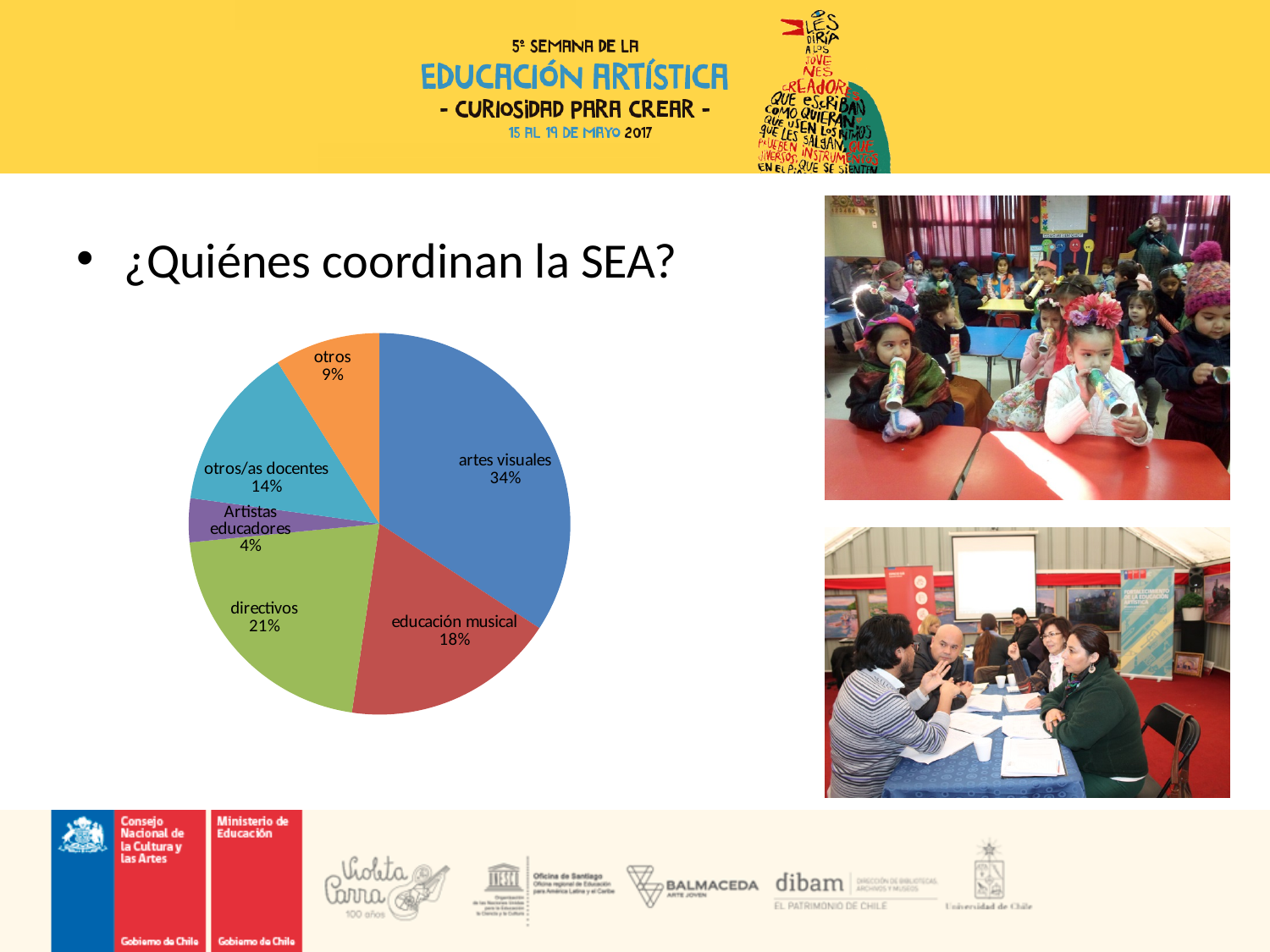
What is the combined share of otros and otros/as docentes? 23% Which category has the largest share of the pie? artes visuales How many categories does the pie chart have? 6 Which category has the smallest share of the pie? Artistas educadores What kind of chart is shown on the slide? pie chart What is the difference between the shares of artes visuales and directivos? 13% What is the value for educación musical? 18% What share of the pie does artes visuales have? 34% What is the value for Artistas educadores? 4% What is the value for otros/as docentes? 14% What is the value for directivos? 21% Which is larger, the share for directivos or the share for educación musical? directivos